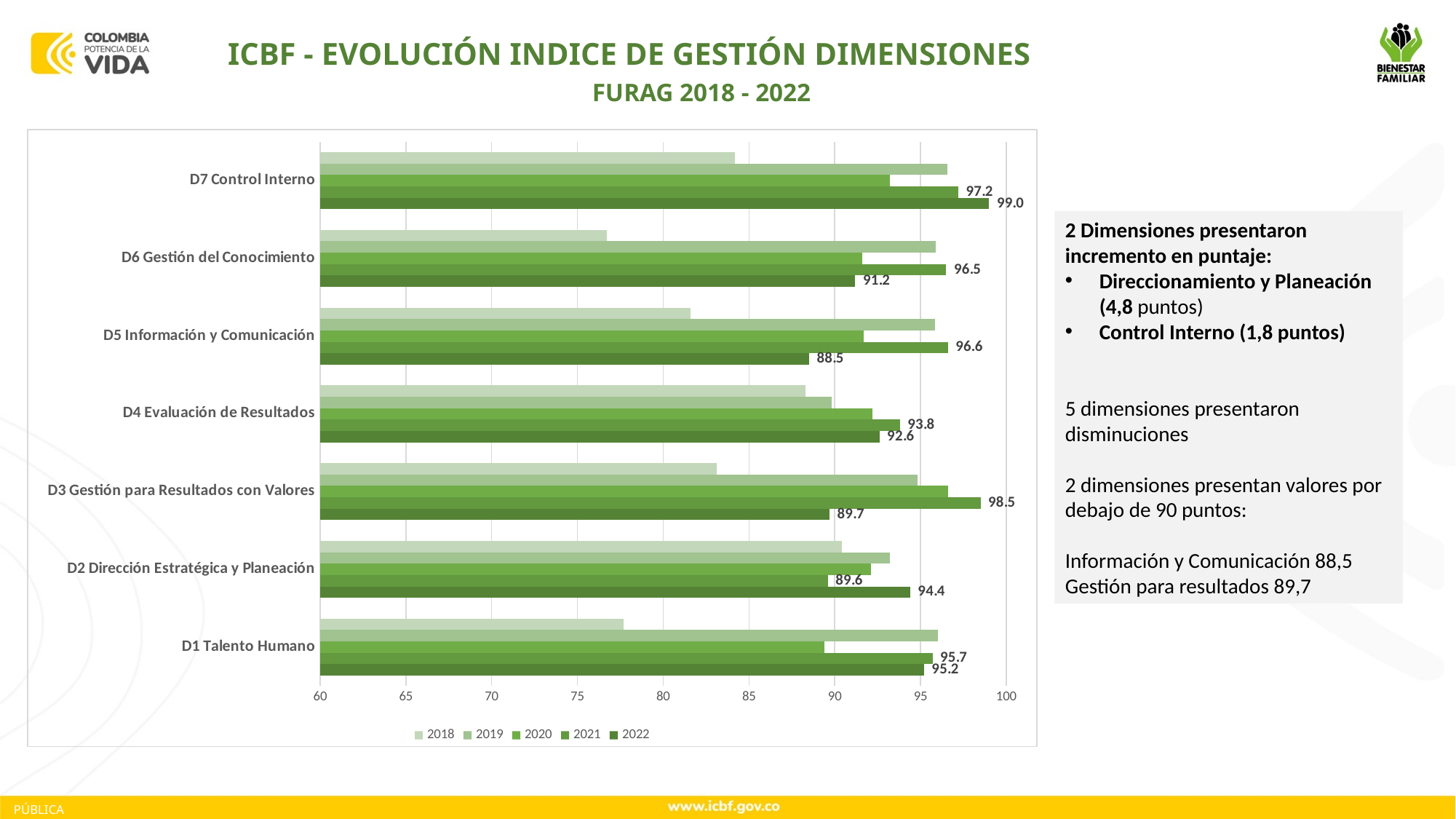
What is the difference between the 2022 and 2021 values for D2 Dirección Estratégica y Planeación? 4.8 What is the 2022 value for D5 Información y Comunicación? 88.5 Is the 2018 value for D6 Gestión del Conocimiento greater or less than 80? less How many series does the legend list? 5 What is the 2022 value for D7 Control Interno? 99.0 Which dimension has the lowest 2022 value? D5 Información y Comunicación How many dimensions are shown on the chart? 7 What kind of chart is shown on the slide? bar chart For D6 Gestión del Conocimiento, which is larger: the 2021 value or the 2022 value? 2021 What is the difference between the 2022 and 2021 values for D7 Control Interno? 1.8 What is the 2021 value for D3 Gestión para Resultados con Valores? 98.5 Which dimension has the highest 2022 value? D7 Control Interno